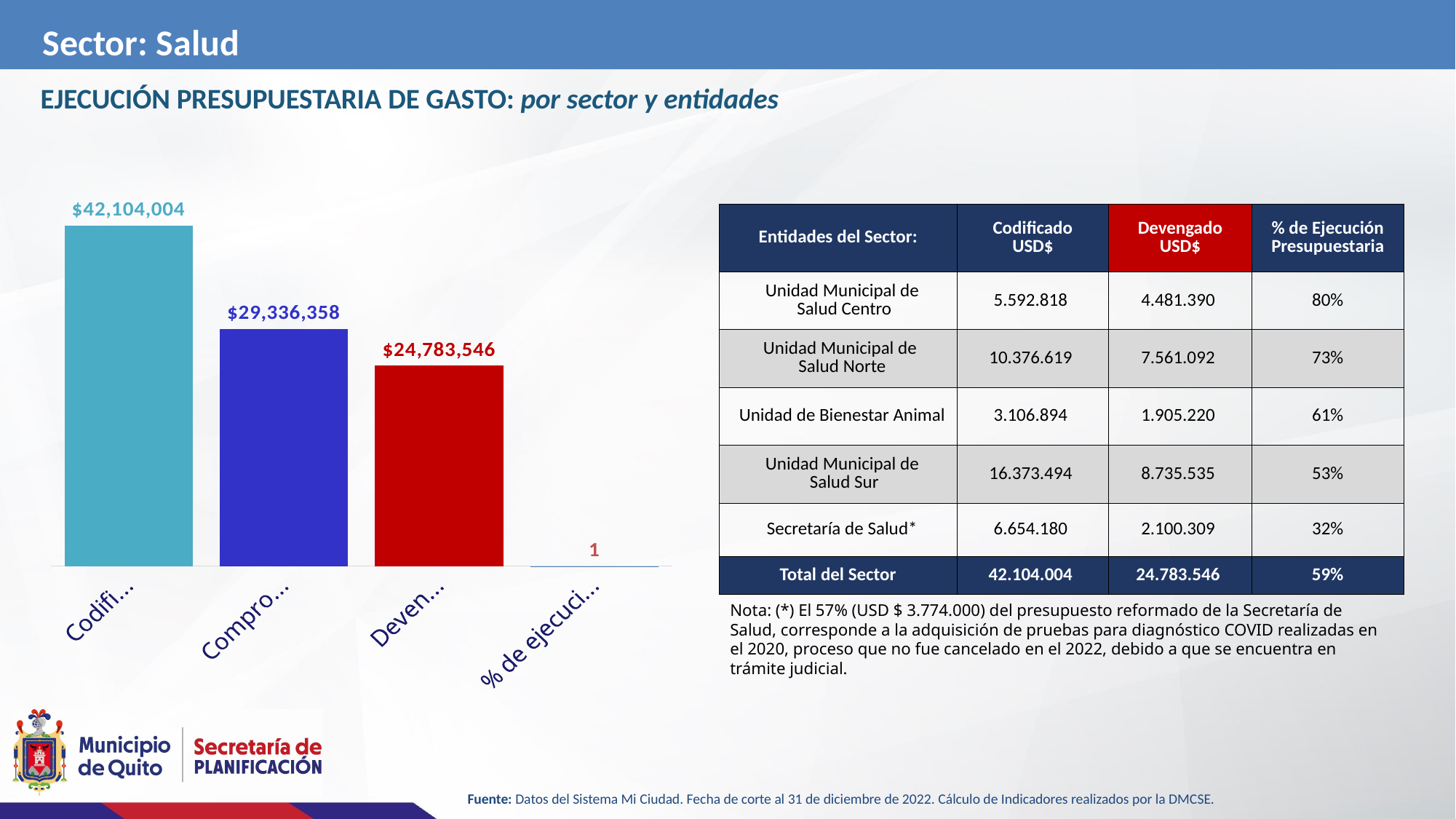
How many categories are shown on the x axis of the chart? 4 What is the value shown on the first bar, labelled "Codifi..."? $42,104,004 What is the difference between the "Compro..." bar and the "Deven..." bar? $4,552,812 What is the value shown on the red bar labelled "Deven..."? $24,783,546 Which is larger, the "Compro..." bar or the "Deven..." bar? Compro... Which of the three tall bars has the lowest value? Deven... What value is printed above the last category, "% de ejecuci..."? 1 What is the value shown on the bar labelled "Compro..."? $29,336,358 What type of chart is shown on the slide? Bar chart What is the difference between the "Codifi..." bar and the "Deven..." bar? $17,320,458 Which bar in the chart has the highest value? Codifi... What colour is the bar labelled "Deven..."? Red